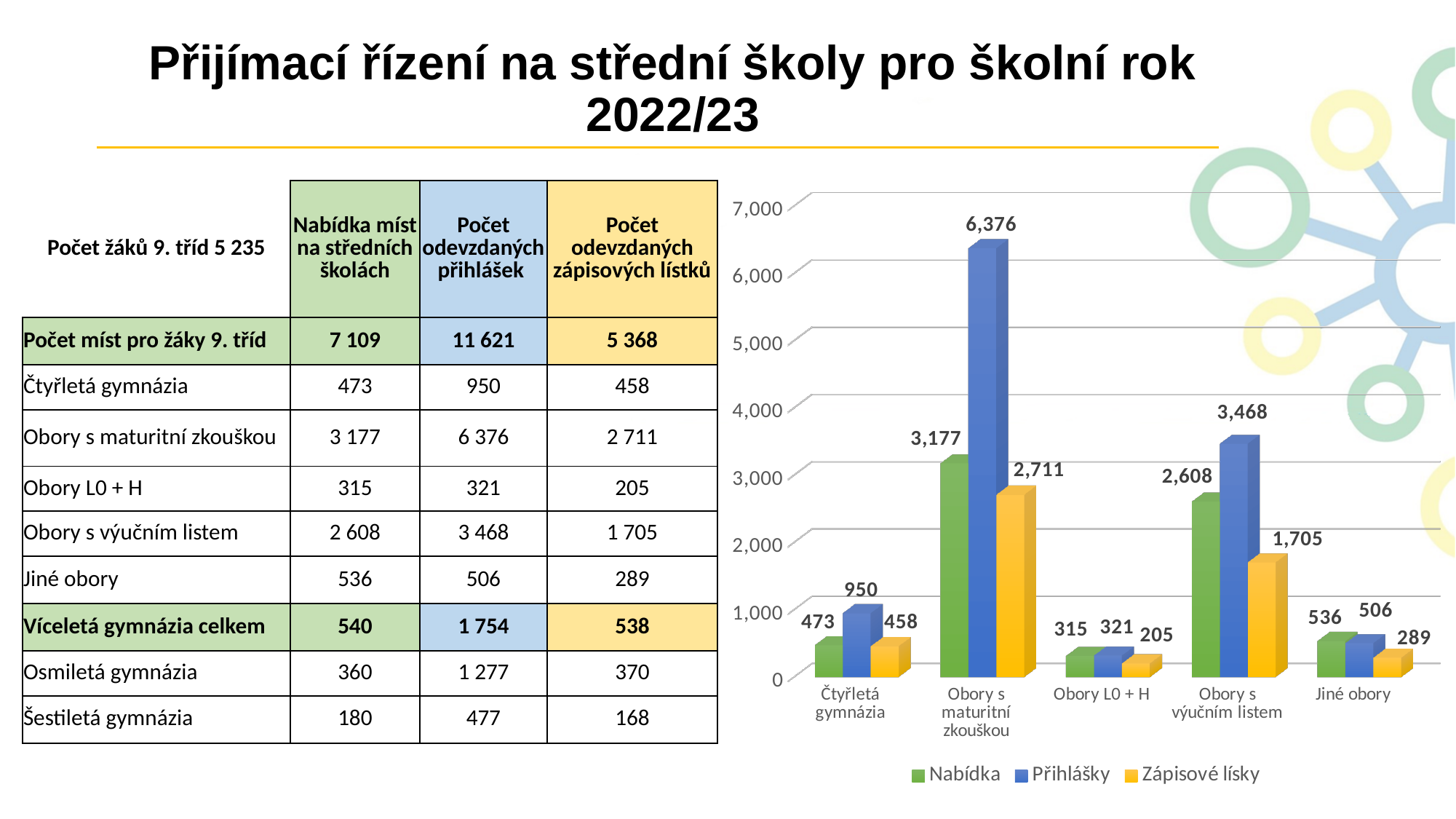
What is the difference between Přihlášky and Nabídka for Obory s výučním listem? 860 Is the Přihlášky value for Obory s maturitní zkouškou greater or less than 6,000? greater What kind of chart is shown on the slide? bar chart Which category has the highest Přihlášky value? Obory s maturitní zkouškou How many series does the chart legend list? 3 Which category has the lowest Zápisové lísky value? Obory L0 + H What is the value of Nabídka for Obory s výučním listem? 2,608 Which series is shown in yellow in the chart legend? Zápisové lísky What is the value of Přihlášky for Obory s maturitní zkouškou? 6,376 Which is larger for Jiné obory: Nabídka or Přihlášky? Nabídka How many categories are shown on the x axis of the chart? 5 What is the value of Zápisové lísky for Čtyřletá gymnázia? 458